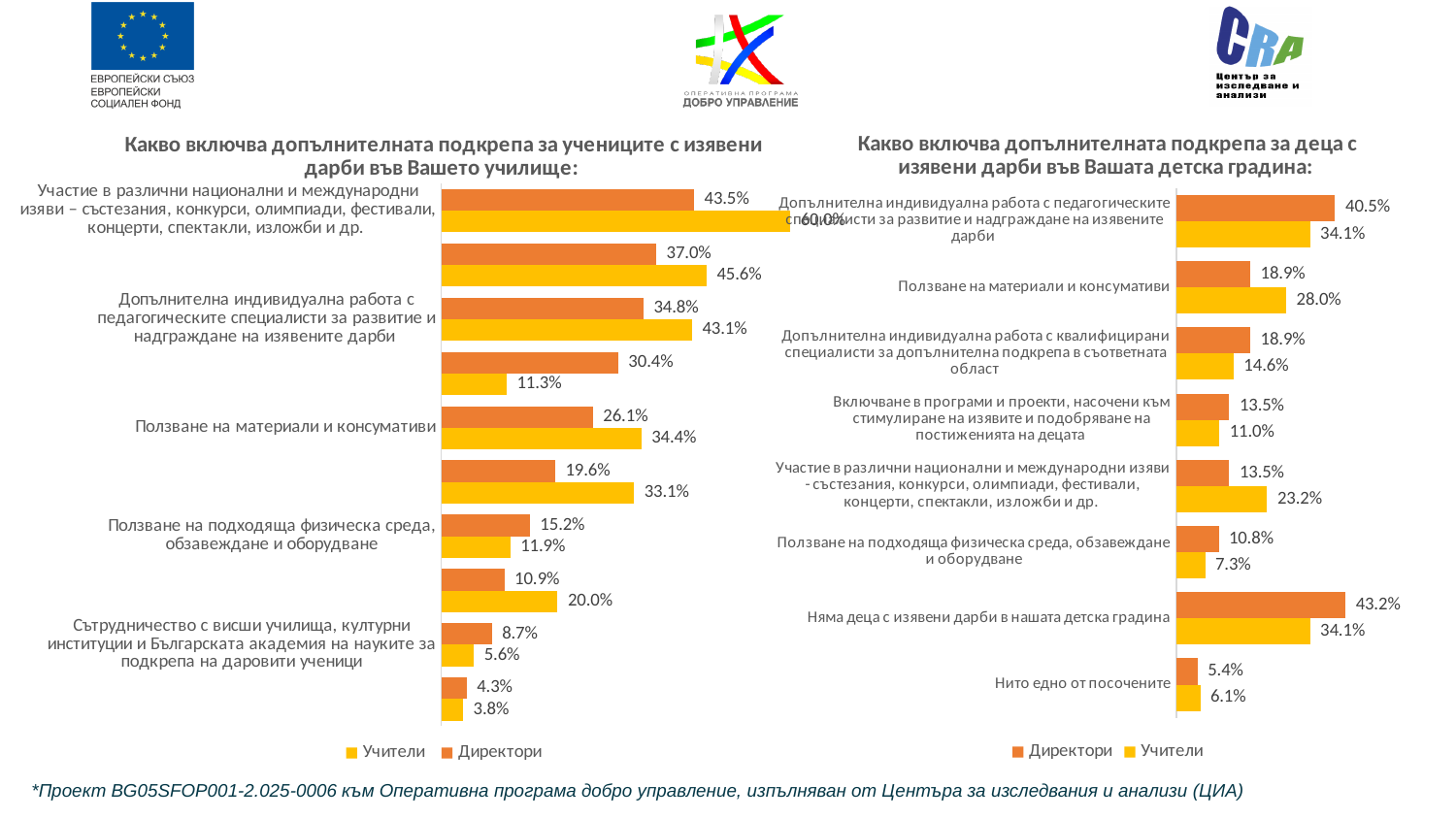
In the right chart (детска градина), which category has the highest Директори value? Няма деца с изявени дарби в нашата детска градина In the right chart (детска градина), for 'Ползване на подходяща физическа среда, обзавеждане и оборудване', which series has the larger value, Директори or Учители? Директори In the right chart (детска градина), what percentage of Учители chose 'Ползване на материали и консумативи'? 28.0% In the right chart (детска градина), what is the Директори value for 'Няма деца с изявени дарби в нашата детска градина'? 43.2% What type of chart is the left chart (училище)? Bar chart How many series does the legend of the left chart (училище) list? 2 In the right chart (детска градина), what is the Учители value for 'Участие в различни национални и международни изяви'? 23.2% In the right chart (детска градина), which category has the lowest Директори value? Нито едно от посочените In the left chart (училище), what is the highest value shown for the Учители series? 60.0% In the right chart (детска градина), what percentage of Директори chose 'Ползване на материали и консумативи'? 18.9% How many categories are shown in the right chart (детска градина)? 8 In the right chart (детска градина), what is the difference between the Директори and Учители values for 'Допълнителна индивидуална работа с педагогическите специалисти за развитие и надграждане на изявените дарби'? 6.4%